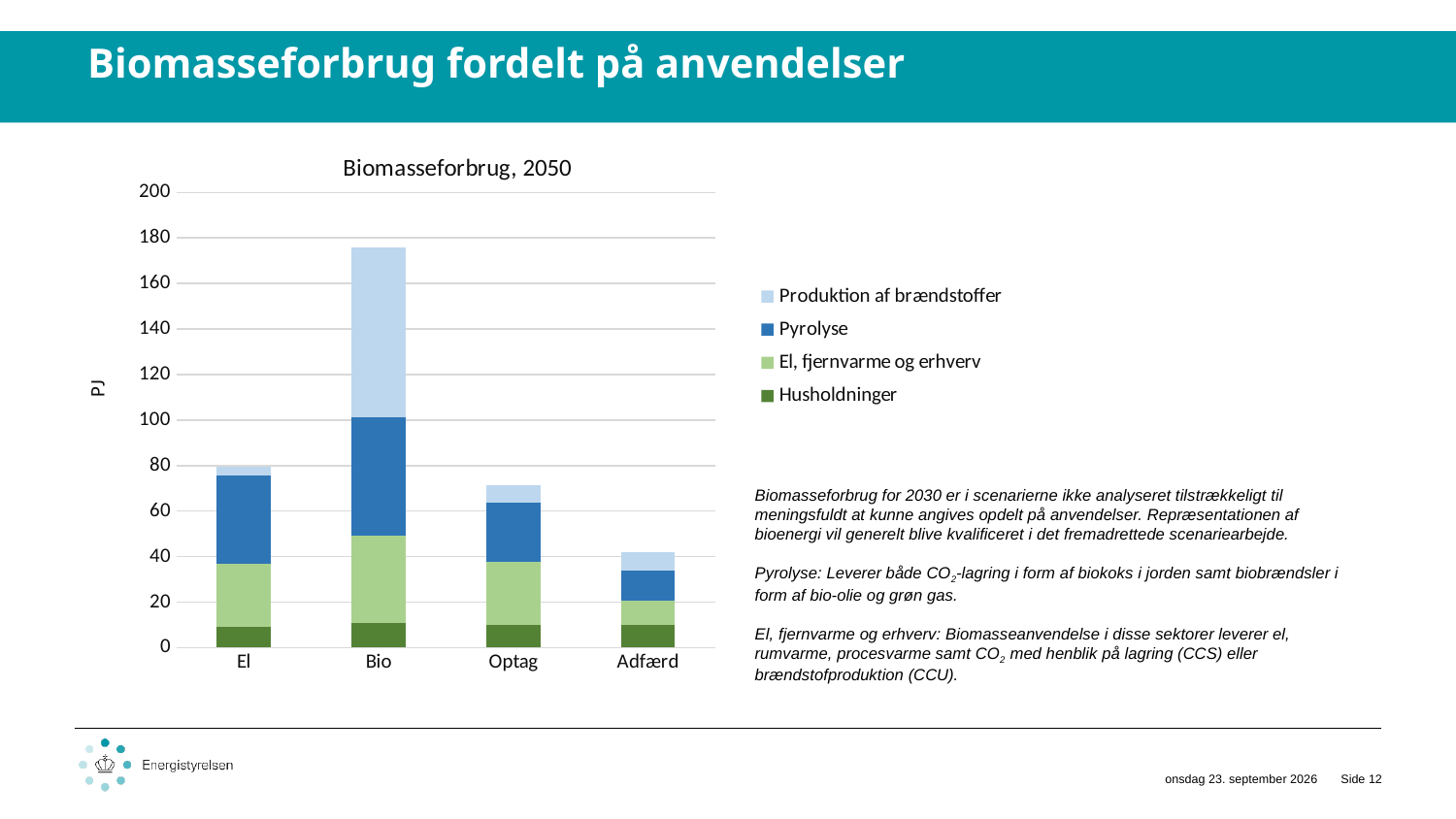
Which category has the highest total bar in the chart? Bio What is the title of the chart? Biomasseforbrug, 2050 Which has a larger total bar, Bio or El? Bio Which category has the lowest total bar in the chart? Adfærd How many categories are shown on the x axis of the chart? 4 What kind of chart is shown on the slide? Stacked bar chart Which has a larger total bar, Optag or Adfærd? Optag Is the total value for Optag greater or less than 60? greater Is the total value for Bio greater or less than 160? greater How many series does the chart's legend list? 4 What unit is shown on the y axis of the chart? PJ Is the total value for Adfærd greater or less than 60? less